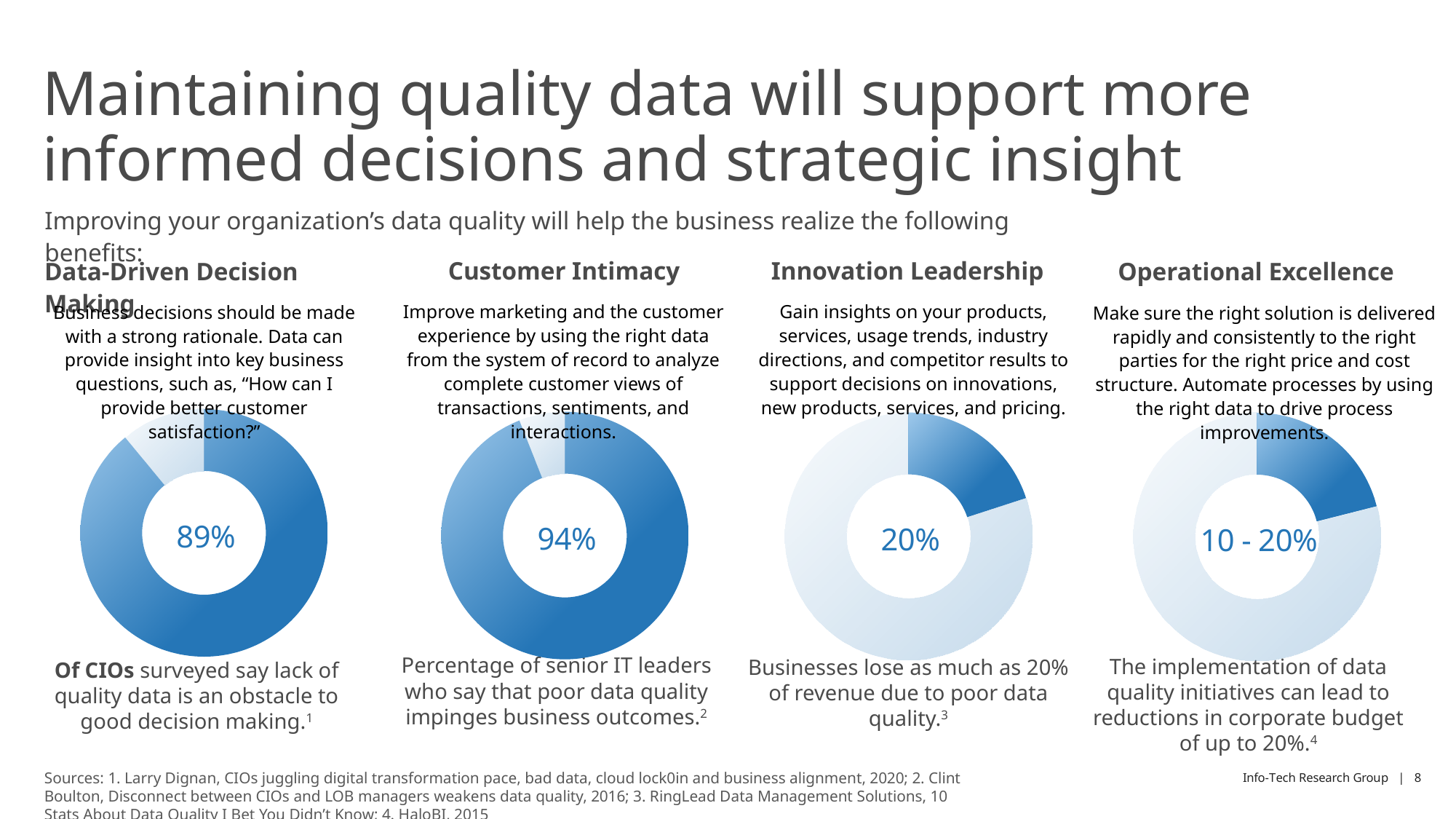
What value is shown in the centre of the Data-Driven Decision Making donut chart? 89% What value is shown in the centre of the Customer Intimacy donut chart? 94% How many donut charts are on the slide? 4 What is the difference between the Customer Intimacy value and the Data-Driven Decision Making value? 5 percentage points What value is shown in the centre of the Innovation Leadership donut chart? 20% Which donut chart shows a larger value: Data-Driven Decision Making or Customer Intimacy? Customer Intimacy Which of the four donut charts shows the highest percentage in its centre? Customer Intimacy (94%) Which donut chart shows the percentage of senior IT leaders who say poor data quality impinges business outcomes? Customer Intimacy (94%) What colour is the filled portion of the donut charts? Blue What value is shown in the centre of the Operational Excellence donut chart? 10 - 20% Is the value shown in the Innovation Leadership donut chart greater or less than 50%? less What kind of chart is used under each of the four benefit headings? Donut chart